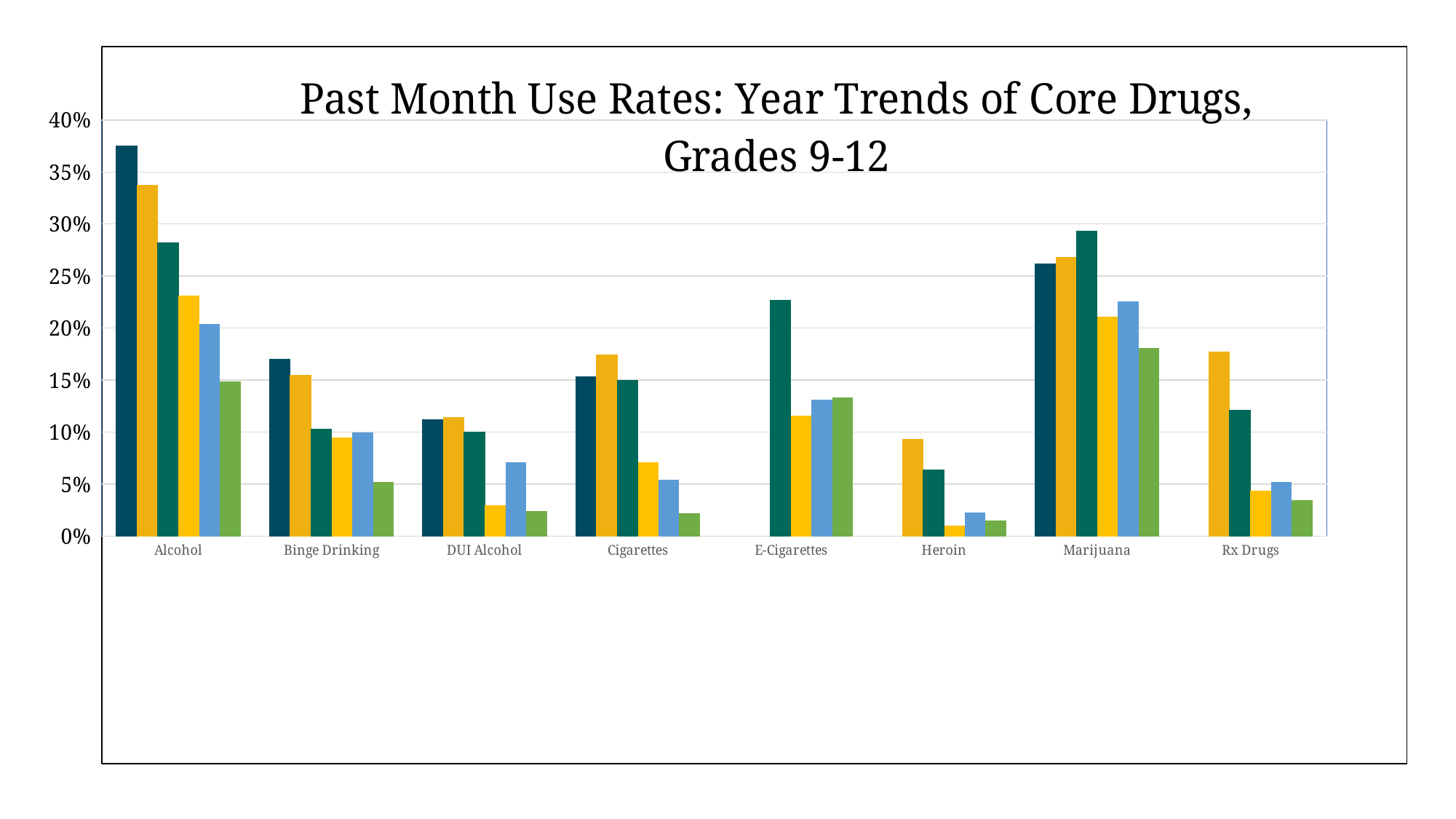
Is the tallest bar for Alcohol greater or less than 35%? greater Is the tallest bar for E-Cigarettes greater or less than 20%? greater Which category has a taller maximum bar, Alcohol or Marijuana? Alcohol Is the tallest bar for Heroin greater or less than 10%? less Which category has a taller maximum bar, Binge Drinking or Heroin? Binge Drinking What kind of chart is shown on the slide? bar chart What is the title of the chart? Past Month Use Rates: Year Trends of Core Drugs, Grades 9-12 Which category has the tallest bar in the chart? Alcohol How many drug categories are shown on the x axis? 8 How many bars are shown for the E-Cigarettes category? 4